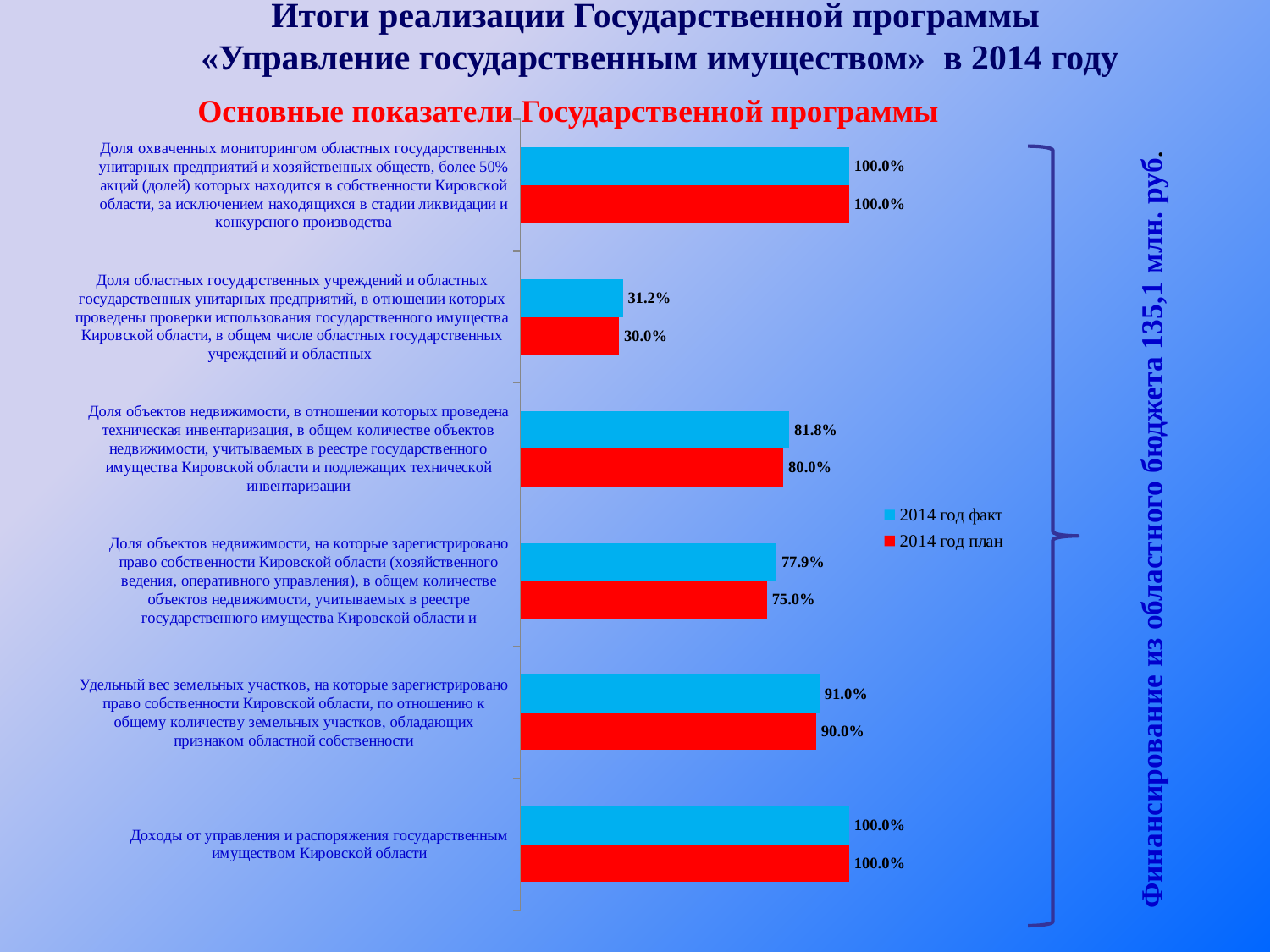
Which indicator has the lowest 2014 год план value? Доля областных государственных учреждений и областных государственных унитарных предприятий, в отношении которых проведены проверки использования государственного имущества What is the difference between the 2014 год факт and 2014 год план values for 'Доля объектов недвижимости, на которые зарегистрировано право собственности Кировской области'? 2.9% What is the 2014 год факт value for the indicator 'Доля областных государственных учреждений и областных государственных унитарных предприятий, в отношении которых проведены проверки использования государственного имущества'? 31.2% Which series is shown in red in the chart legend? 2014 год план How many categories (indicators) are plotted on the chart? 6 How many series does the chart legend list? 2 What is the title shown above the chart? Основные показатели Государственной программы What kind of chart is shown on the slide? bar chart What is the 2014 год план value for the indicator 'Доля объектов недвижимости, в отношении которых проведена техническая инвентаризация'? 80.0% What is the 2014 год факт value for 'Удельный вес земельных участков, на которые зарегистрировано право собственности Кировской области'? 91.0% What is the 2014 год план value for 'Доходы от управления и распоряжения государственным имуществом Кировской области'? 100.0% For 'Доля объектов недвижимости, в отношении которых проведена техническая инвентаризация', which is larger: the 2014 год факт value or the 2014 год план value? 2014 год факт